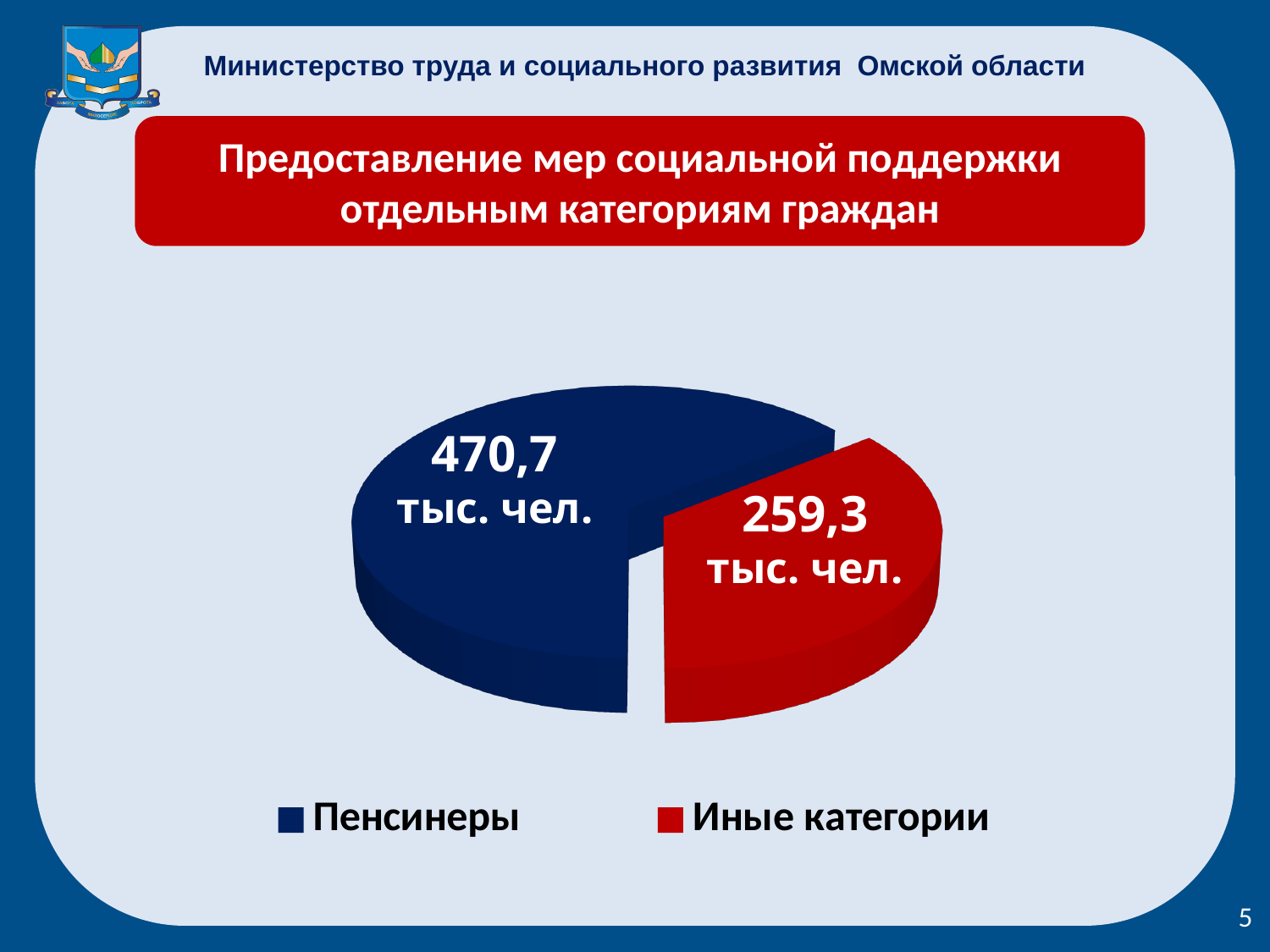
What is the difference between the value for Пенсинеры and the value for Иные категории? 211,4 тыс. чел. What kind of chart is shown on the slide? Pie chart How many entries does the legend list? 2 What is the total of the two slices in the pie chart? 730 тыс. чел. What is the value for Иные категории? 259,3 тыс. чел. What colour is the slice for Иные категории? Red Which is larger, the value for Пенсинеры or the value for Иные категории? Пенсинеры What is the value for Пенсинеры? 470,7 тыс. чел. Which category has the smallest slice of the pie? Иные категории Which category has the largest slice of the pie? Пенсинеры What share of the pie does Пенсинеры represent? 64,5% How many slices does the pie chart have? 2